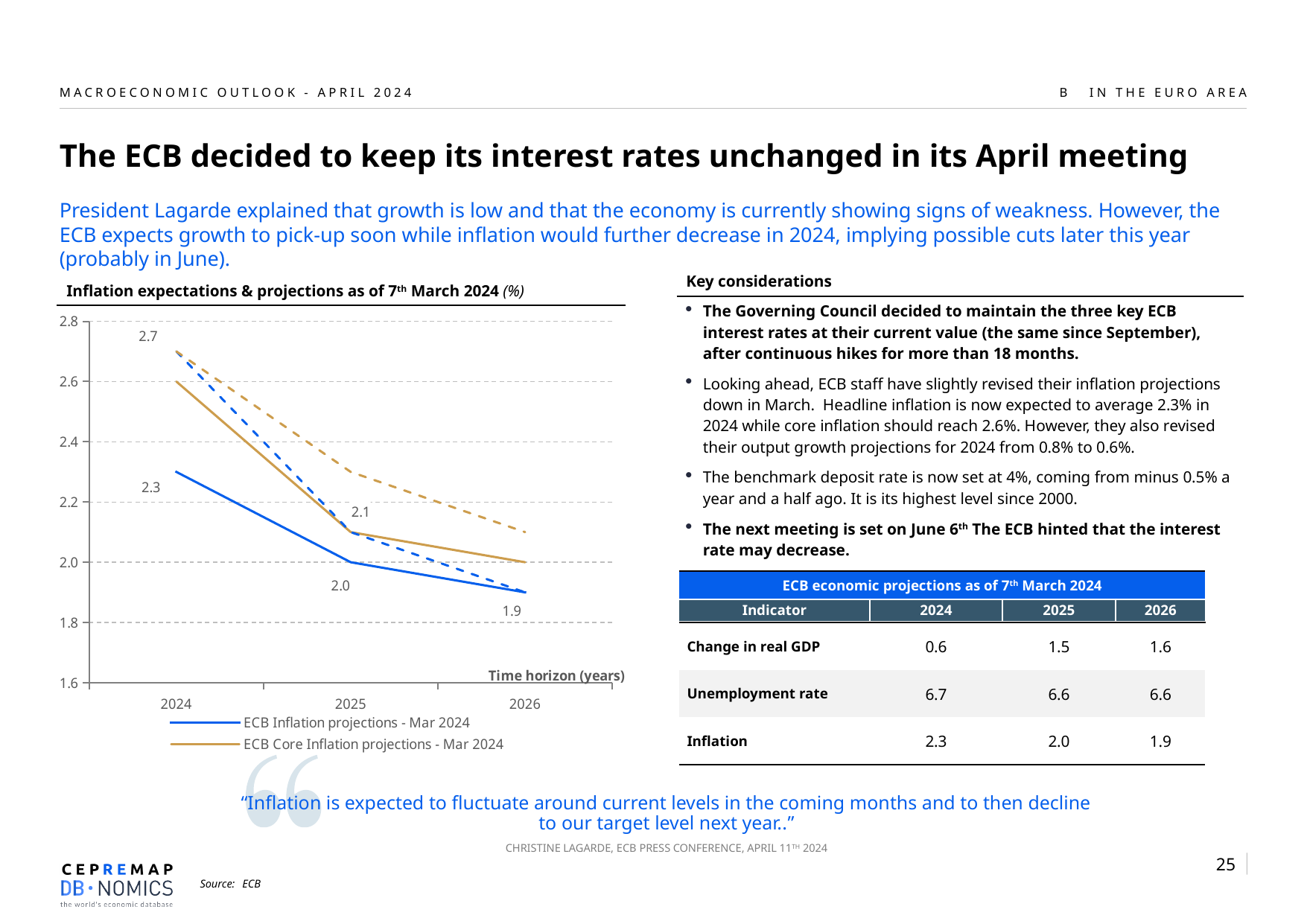
What is the ECB Inflation projection (Mar 2024) for 2024? 2.3 By how much does the ECB Inflation projection fall between 2024 and 2026? 0.4 How many years are shown on the x axis of the chart? 3 What is the ECB Inflation projection (Mar 2024) for 2026? 1.9 Is the ECB Core Inflation projection for 2024 greater or less than 2.4? greater What is the ECB Inflation projection (Mar 2024) for 2025? 2.0 In 2025, which is higher: the ECB Core Inflation projection or the ECB Inflation projection? ECB Core Inflation projections - Mar 2024 What is the ECB Core Inflation projection (Mar 2024) for 2025? 2.1 How many series does the chart legend list? 2 What kind of chart is shown on the slide? line chart Do the ECB Inflation projections rise or fall from 2024 to 2026? fall Which year has the highest ECB Inflation projection? 2024